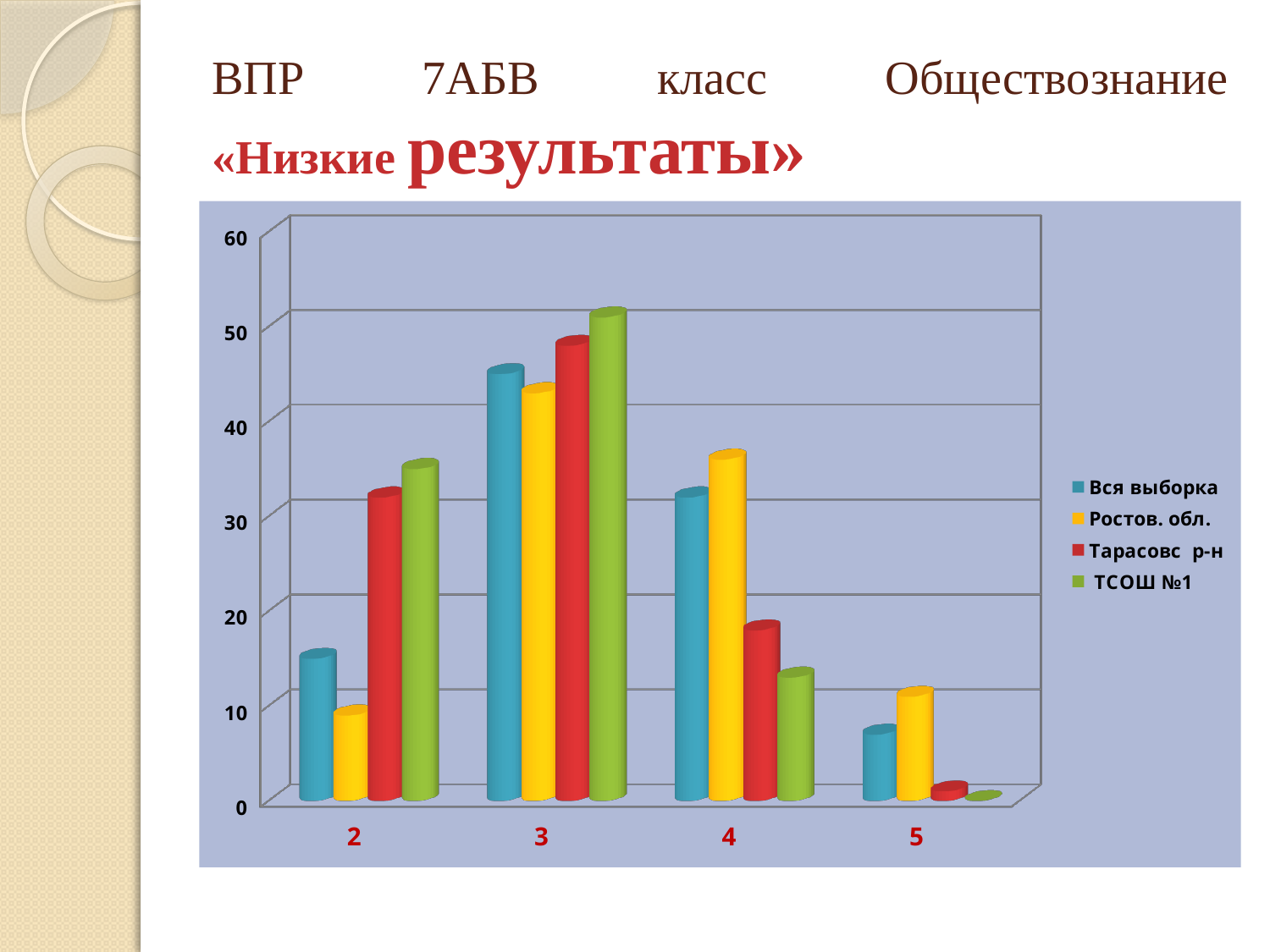
In category 4, which is larger: Ростов. обл. or ТСОШ №1? Ростов. обл. For which category is the value of ТСОШ №1 highest? 3 Is the value for ТСОШ №1 in category 3 greater or less than 40? greater In category 2, which is larger: Вся выборка or Тарасовс р-н? Тарасовс р-н Do the values for ТСОШ №1 rise or fall from category 3 to category 5? fall Is the value for Тарасовс р-н in category 2 greater or less than 20? greater How many series does the chart legend list? 4 Which series is shown in green in the chart legend? ТСОШ №1 Is the value for Вся выборка in category 2 greater or less than 20? less What kind of chart is shown on the slide? bar chart For which category is the value of Ростов. обл. lowest? 5 How many categories are shown on the x axis of the chart? 4